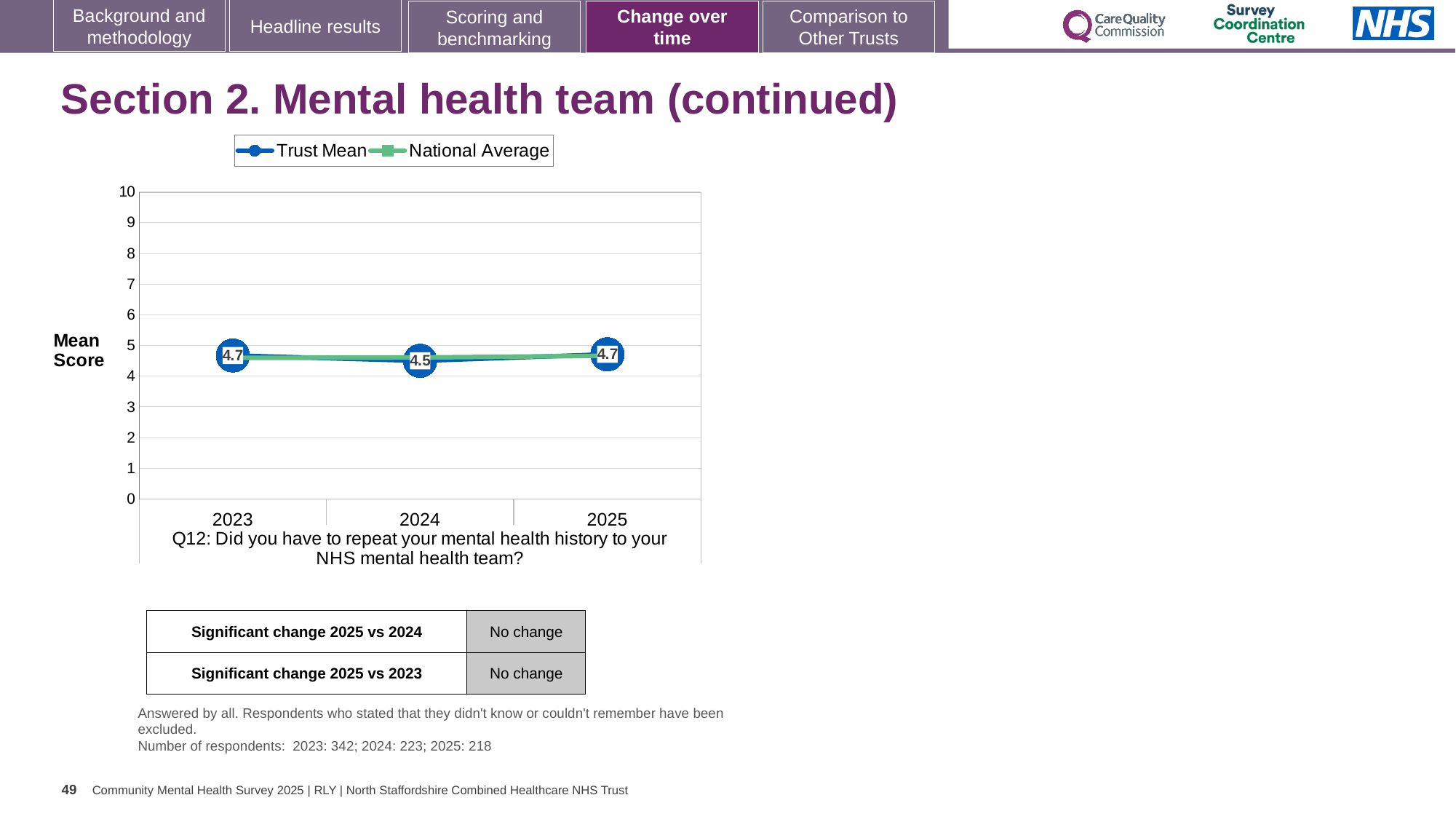
How many years are plotted on the x axis? 3 What is the Trust Mean score for 2024? 4.5 What is the Trust Mean score for 2023? 4.7 What is the Trust Mean score for 2025? 4.7 What kind of chart is shown on the slide? Line chart Does the Trust Mean score rise or fall from 2023 to 2024? fall What are the two series named in the legend? Trust Mean and National Average In which year is the Trust Mean score lowest? 2024 How many series does the legend list? 2 What is the difference between the Trust Mean score in 2025 and in 2024? 0.2 Which is larger, the Trust Mean score for 2023 or for 2024? 2023 Is the National Average value for 2024 greater or less than 5? less